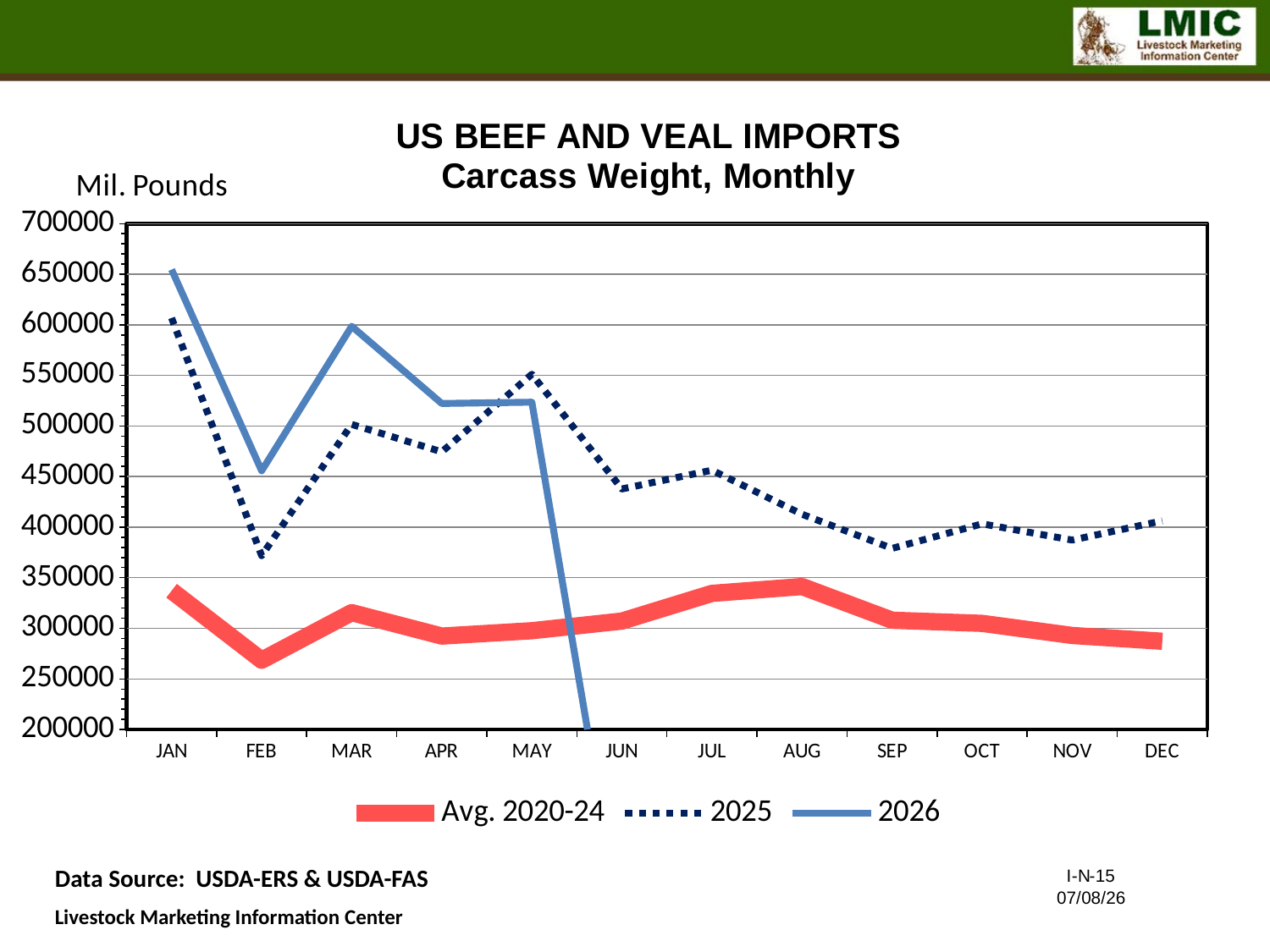
In which month does the 2026 series reach its highest value? JAN Does the Avg. 2020-24 series rise or fall from AUG to DEC? fall Is the Avg. 2020-24 value for FEB greater or less than 300000? less What unit label is shown above the y axis? Mil. Pounds Is the 2026 value for FEB greater or less than 500000? less What kind of chart is shown on the slide? line chart How many months are shown along the x axis? 12 Is the 2025 value for FEB greater or less than 400000? less How many series does the legend list? 3 In which month is the Avg. 2020-24 series at its lowest? FEB In MAR, which series is higher, 2025 or 2026? 2026